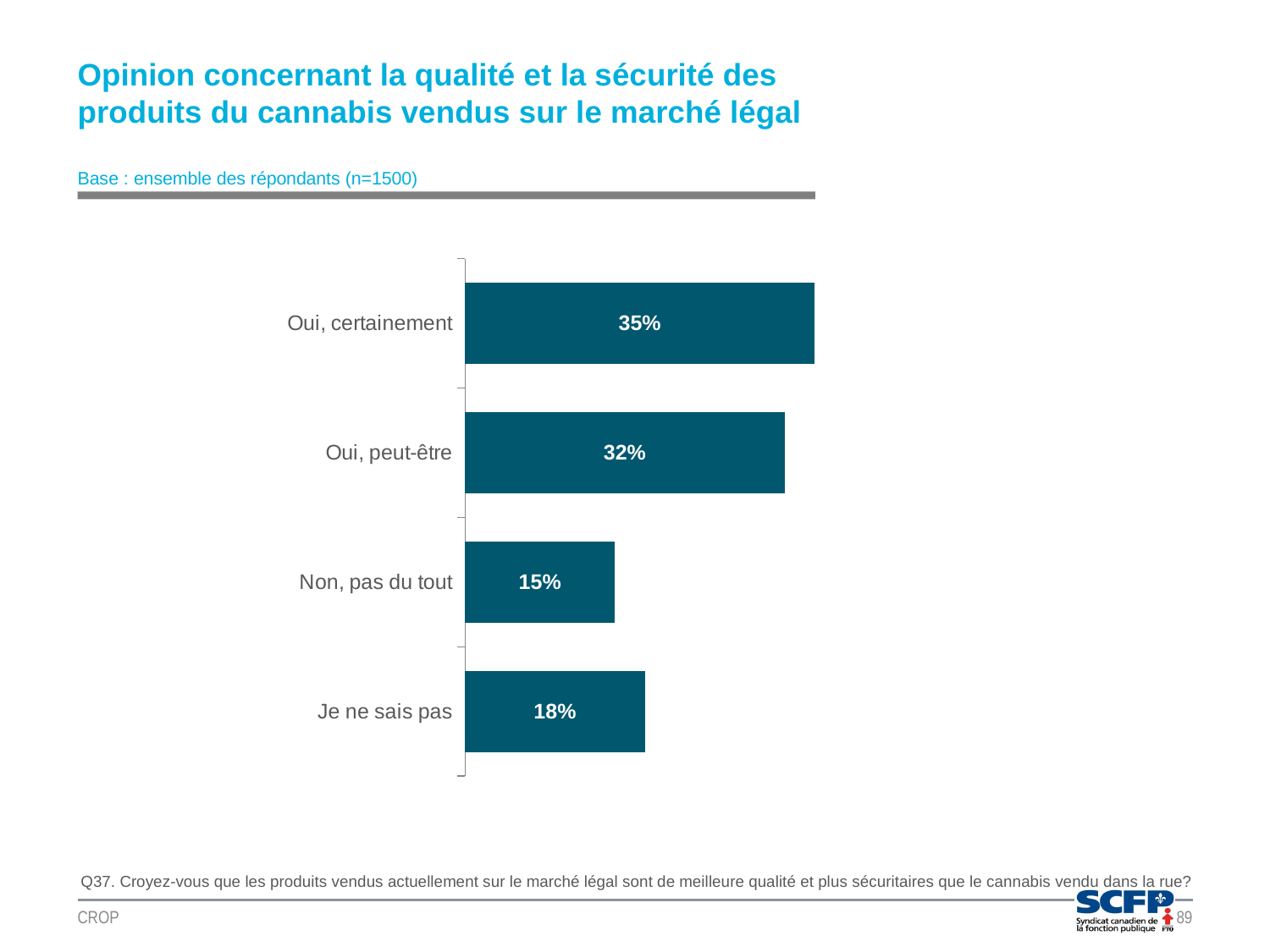
What is the base (number of respondents) stated for the chart? n=1500 Which is larger, the value for "Je ne sais pas" or the value for "Non, pas du tout"? Je ne sais pas How many categories are shown in the chart? 4 Which category has the highest value? Oui, certainement What kind of chart is shown on the slide? Bar chart Which category has the lowest value? Non, pas du tout What is the difference between the values for "Je ne sais pas" and "Non, pas du tout"? 3% What is the value for "Non, pas du tout"? 15% What is the value for "Oui, certainement"? 35% What is the value for "Oui, peut-être"? 32% What is the difference between the values for "Oui, certainement" and "Oui, peut-être"? 3% What is the value for "Je ne sais pas"? 18%